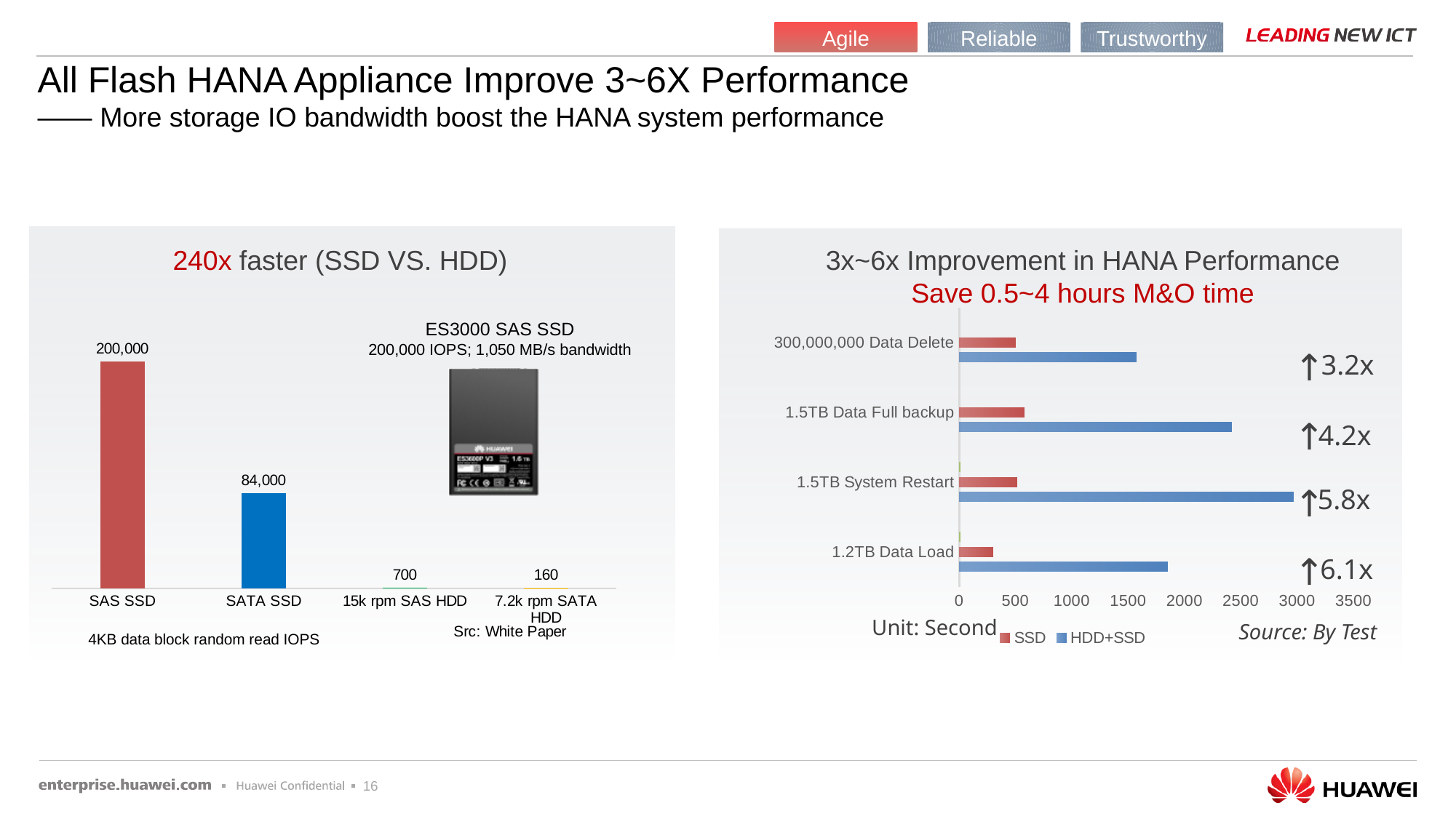
What kind of chart is the right chart titled "3x~6x Improvement in HANA Performance"? Bar chart In the right chart titled "3x~6x Improvement in HANA Performance", is the SSD value for 1.2TB Data Load greater or less than 500? less In the left chart titled "240x faster (SSD VS. HDD)", what is the value for 7.2k rpm SATA HDD? 160 In the left chart titled "240x faster (SSD VS. HDD)", which category has the lowest value? 7.2k rpm SATA HDD In the right chart titled "3x~6x Improvement in HANA Performance", which category has the highest HDD+SSD value? 1.5TB System Restart In the left chart titled "240x faster (SSD VS. HDD)", what is the IOPS value for SATA SSD? 84,000 In the right chart titled "3x~6x Improvement in HANA Performance", how many series does the legend list? 2 In the left chart titled "240x faster (SSD VS. HDD)", what is the difference between the 15k rpm SAS HDD and 7.2k rpm SATA HDD values? 540 In the left chart titled "240x faster (SSD VS. HDD)", what is the IOPS value for SAS SSD? 200,000 In the left chart titled "240x faster (SSD VS. HDD)", how many categories are shown? 4 In the left chart titled "240x faster (SSD VS. HDD)", what is the difference between the SAS SSD and SATA SSD values? 116,000 In the right chart titled "3x~6x Improvement in HANA Performance", is the HDD+SSD value for 1.5TB System Restart greater or less than 2500? greater